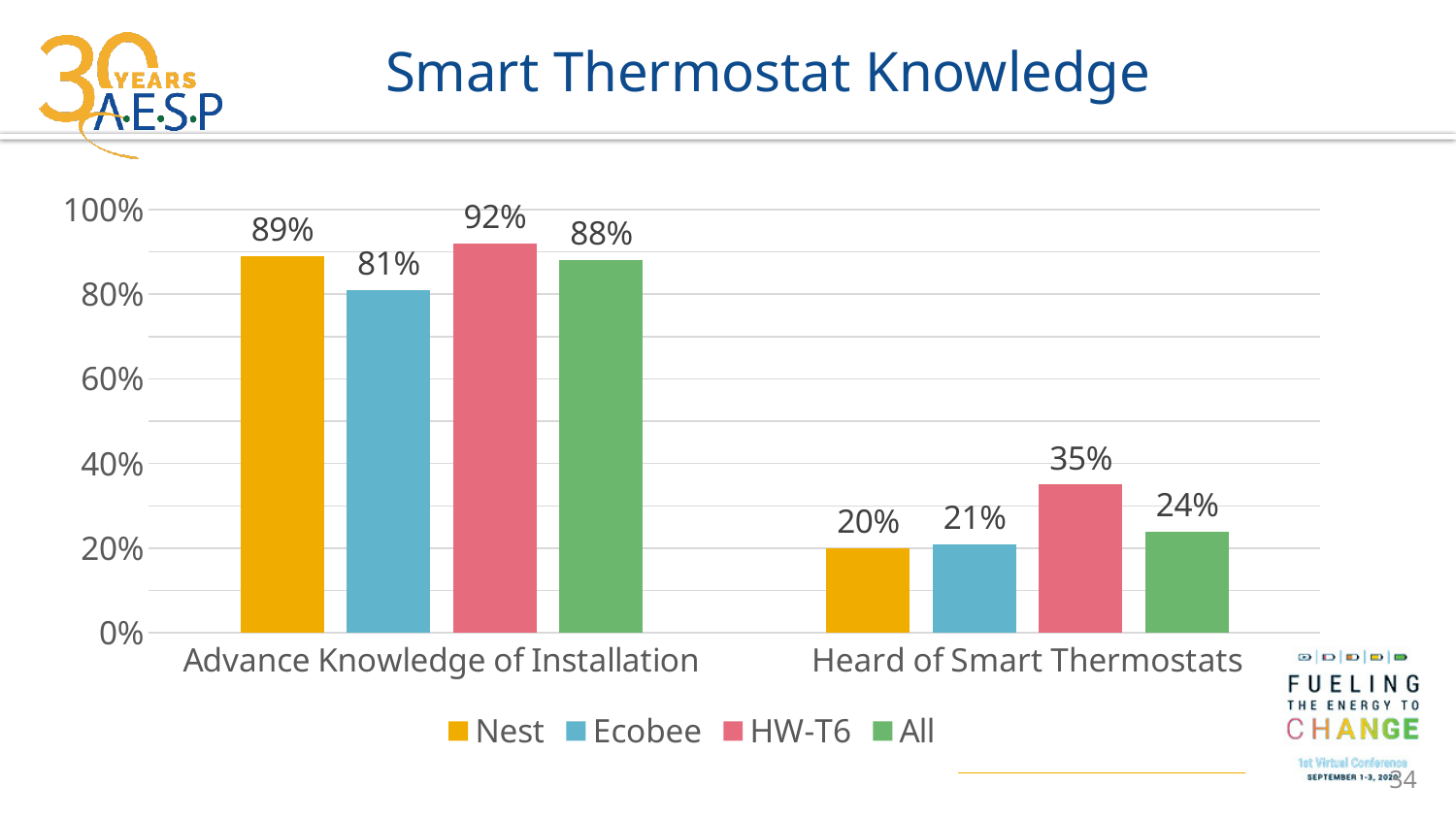
How many categories are shown on the x axis? 2 What kind of chart is shown on the slide? Bar chart What colour represents the HW-T6 series? Red (pink) What is the value for All under Advance Knowledge of Installation? 88% What is the value for HW-T6 under Heard of Smart Thermostats? 35% Which series has the highest value under Advance Knowledge of Installation? HW-T6 Is the value for Ecobee under Advance Knowledge of Installation greater or less than 80%? greater What is the difference between the HW-T6 and Ecobee values under Advance Knowledge of Installation? 11% How many series does the legend list? 4 Which series has the lowest value under Heard of Smart Thermostats? Nest What is the value for Nest under Advance Knowledge of Installation? 89% Which is larger: the All value under Heard of Smart Thermostats or the Ecobee value under Heard of Smart Thermostats? All